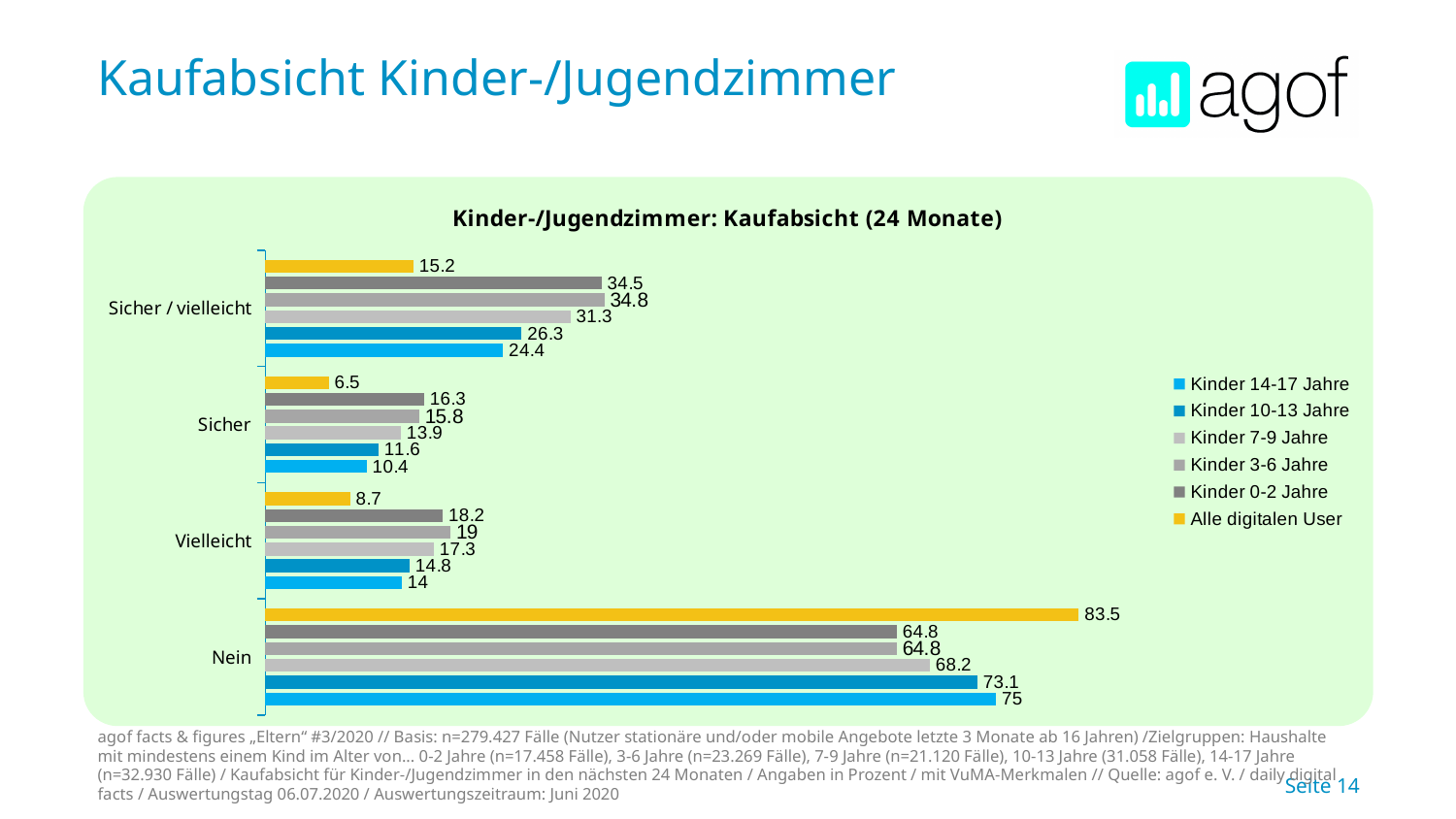
Which series has the highest value in the Vielleicht category? Kinder 3-6 Jahre What type of chart is shown on the slide? bar chart What is the title of the chart? Kinder-/Jugendzimmer: Kaufabsicht (24 Monate) In the Sicher / vielleicht category, which is larger: Kinder 0-2 Jahre or Kinder 10-13 Jahre? Kinder 0-2 Jahre What is the value for Kinder 0-2 Jahre in the Vielleicht category? 18.2 How many categories are shown on the vertical axis? 4 What is the difference between Kinder 14-17 Jahre and Kinder 10-13 Jahre in the Nein category? 1.9 What is the value for Kinder 7-9 Jahre in the Sicher category? 13.9 What is the value for Kinder 14-17 Jahre in the Sicher / vielleicht category? 24.4 What is the value for Alle digitalen User in the Nein category? 83.5 How many series does the legend list? 6 Which series has the lowest value in the Sicher category? Alle digitalen User